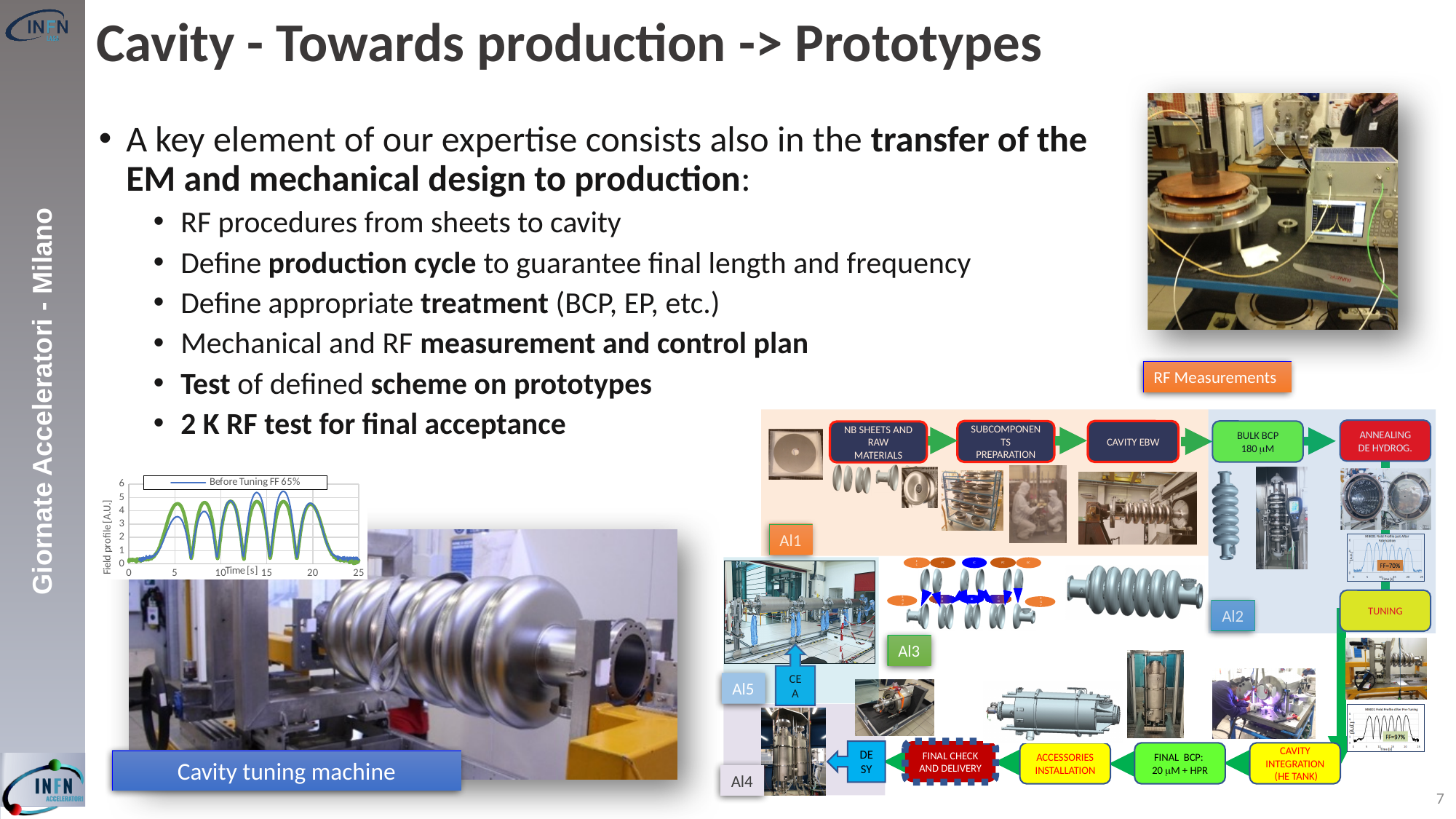
In the bottom-left chart, what is the legend entry shown? Before Tuning FF 65% In the bottom-left chart, is the value of the lines at time 0 greater or less than 1? less What kind of chart is the small chart at the bottom left of the slide (above the cavity tuning machine photo)? line chart In the bottom-left chart, is the highest value reached by the green line greater or less than 3? greater In the bottom-left chart, is the highest value reached by the blue line greater or less than 4? greater In the bottom-left chart, what is the title of the y axis? Field profile [A.U.]